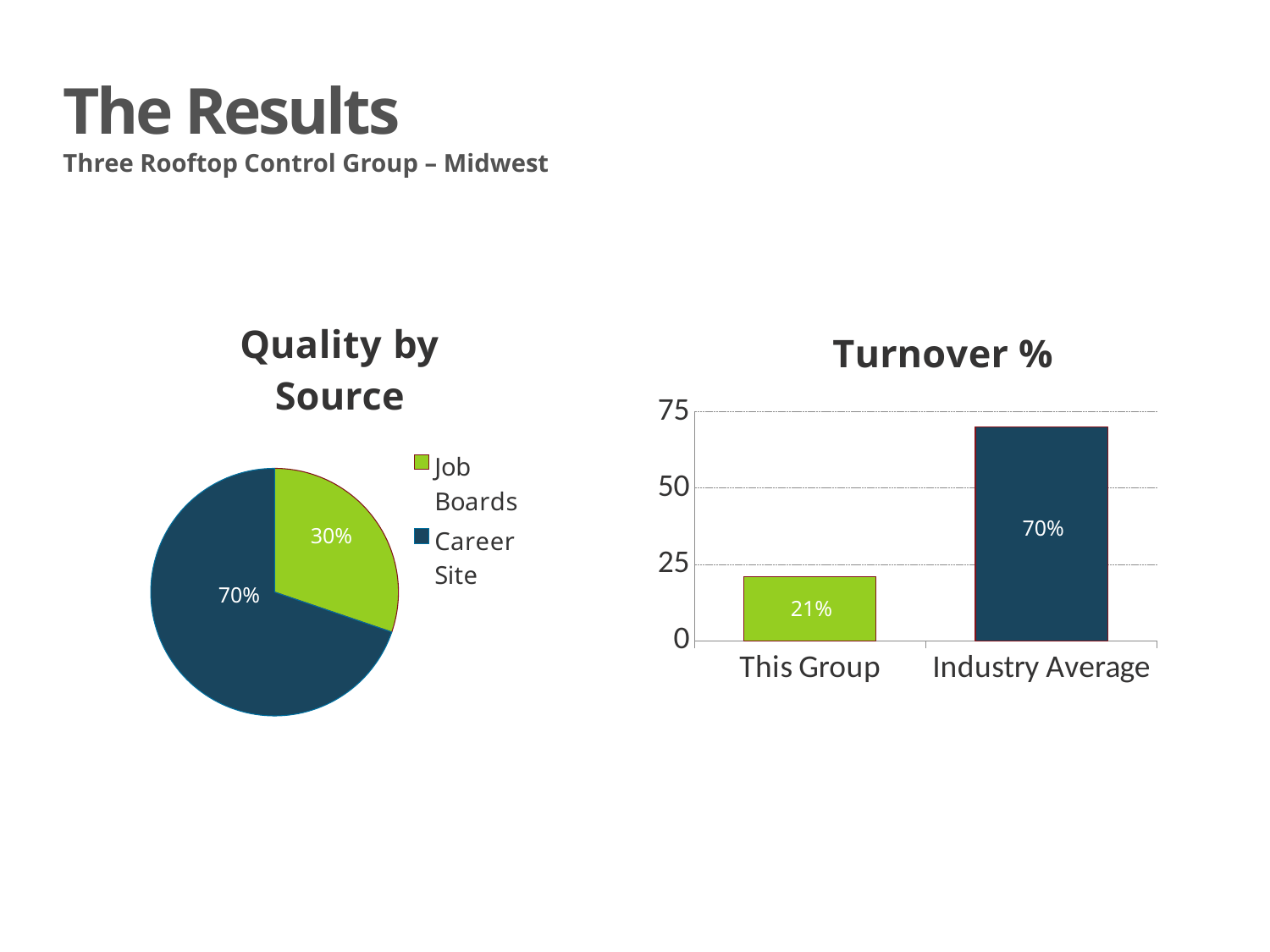
In the 'Turnover %' chart, what is the difference between Industry Average and This Group? 49% In the 'Quality by Source' chart, what colour is the Career Site slice? Dark blue In the 'Turnover %' chart, what is the value for This Group? 21% In the 'Turnover %' chart, which category has the lowest value? This Group What kind of chart is 'Quality by Source'? Pie chart In the 'Turnover %' chart, is the value for Industry Average greater or less than 50? greater In the 'Turnover %' chart, what is the value for Industry Average? 70% In the 'Quality by Source' chart, what share does Job Boards have? 30% What kind of chart is 'Turnover %'? Bar chart How many entries does the legend of the 'Quality by Source' chart list? 2 In the 'Quality by Source' chart, what share does Career Site have? 70% In the 'Quality by Source' chart, which source has the larger slice? Career Site